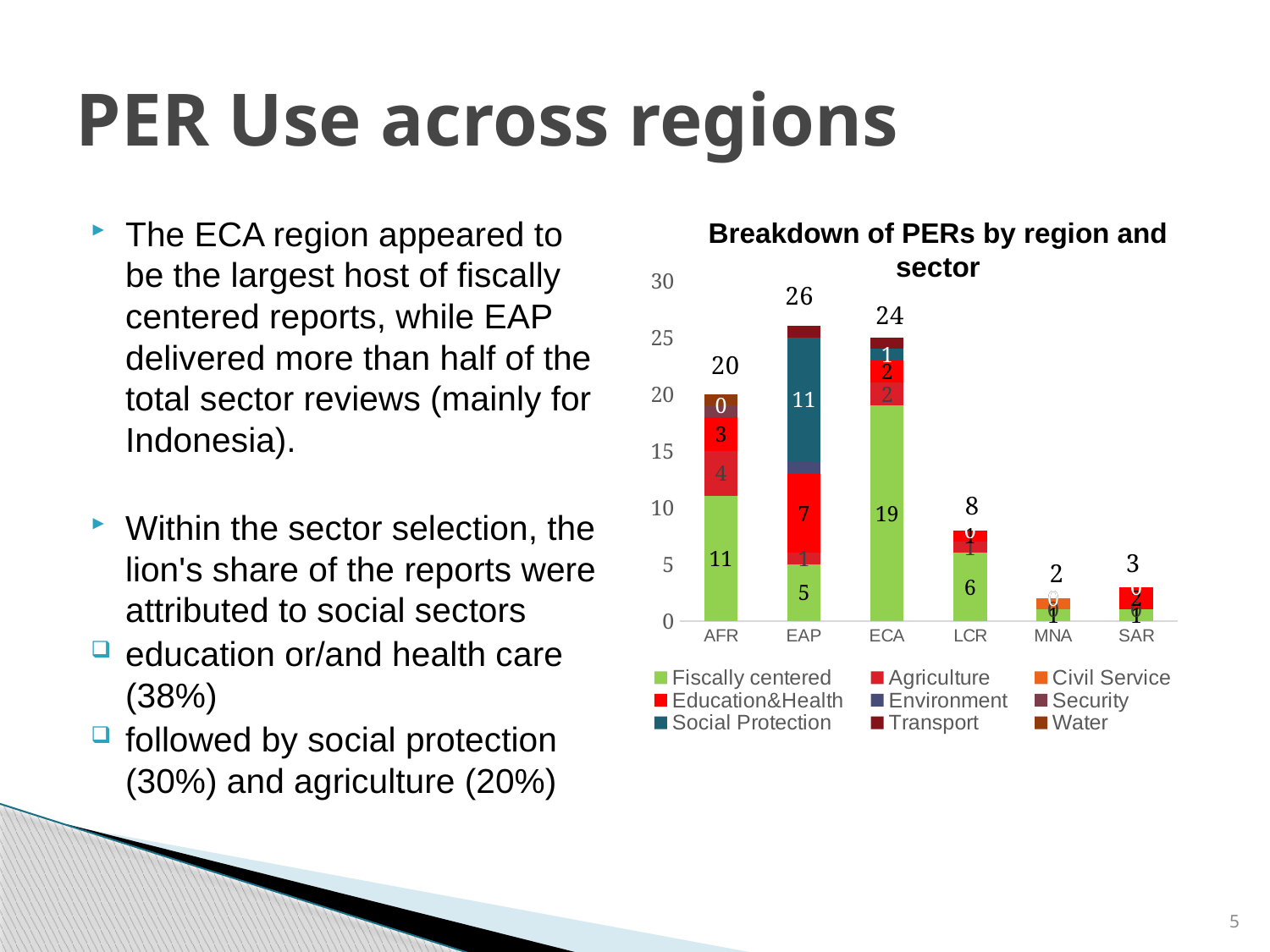
What is the title of the chart? Breakdown of PERs by region and sector What is the total number of PERs for the EAP region? 26 What is the Fiscally centered value for the ECA region? 19 How many regions are shown on the x axis of the chart? 6 Which region has the lowest total number of PERs? MNA What type of chart is shown on the slide? stacked bar chart What is the difference between the total PERs for AFR and LCR? 12 Which region has a larger total of PERs, AFR or ECA? ECA What is the total number of PERs for the ECA region? 24 What is the Social Protection value for the EAP region? 11 How many series does the chart legend list? 9 Which region has the highest total number of PERs? EAP